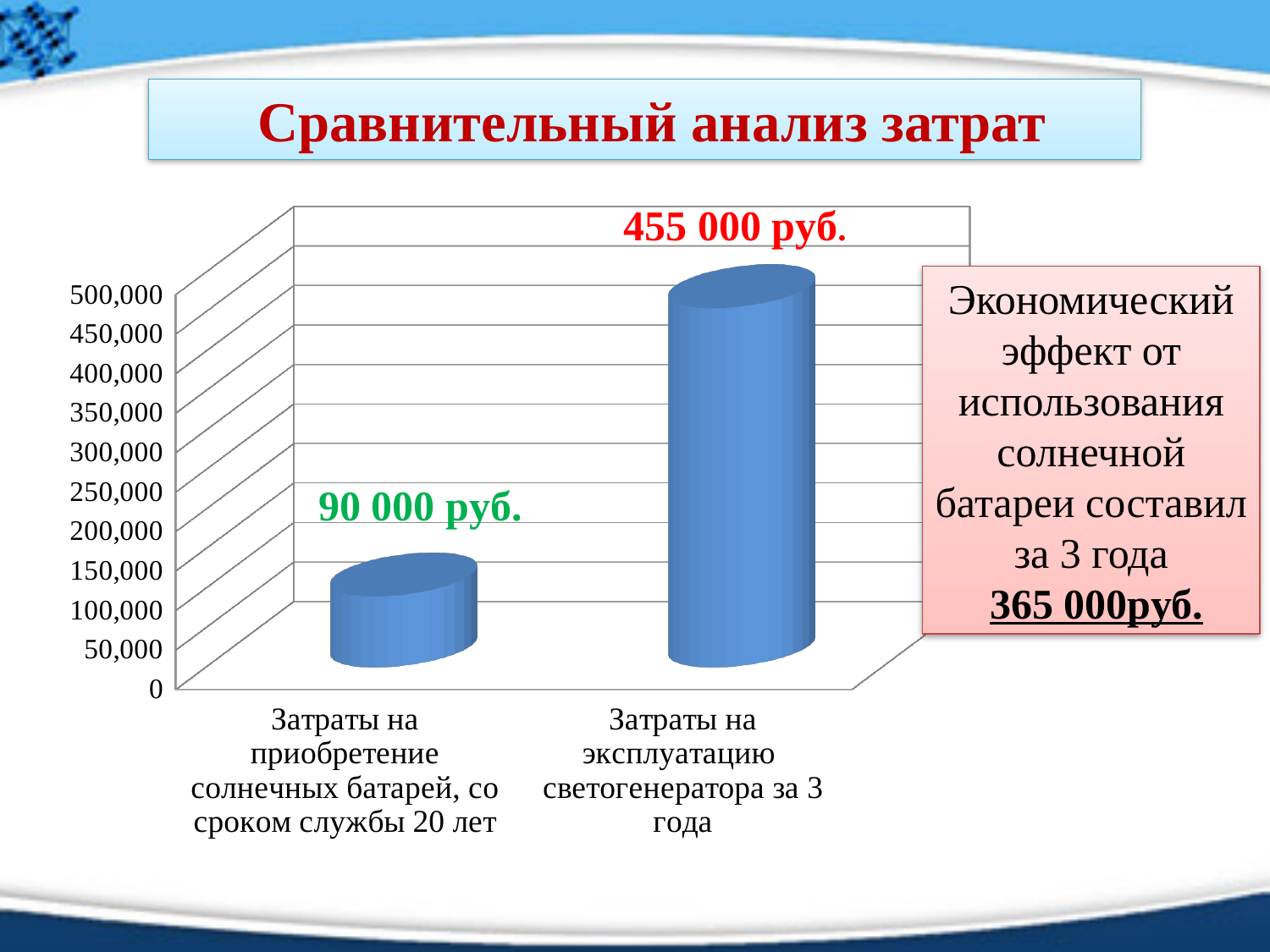
What is the value shown for "Затраты на приобретение солнечных батарей, со сроком службы 20 лет"? 90 000 руб. Which category has the highest value? Затраты на эксплуатацию светогенератора за 3 года What is the title of the slide containing the chart? Сравнительный анализ затрат What kind of chart is shown on the slide? bar chart How many categories are shown on the chart? 2 Is the value for "Затраты на приобретение солнечных батарей, со сроком службы 20 лет" greater or less than 150,000? less What is the highest value labelled on the vertical axis of the chart? 500,000 What is the value shown for "Затраты на эксплуатацию светогенератора за 3 года"? 455 000 руб. Which category has the lowest value? Затраты на приобретение солнечных батарей, со сроком службы 20 лет What is the difference between the value for "Затраты на эксплуатацию светогенератора за 3 года" and the value for "Затраты на приобретение солнечных батарей, со сроком службы 20 лет"? 365 000 руб. Which is larger: the value for "Затраты на приобретение солнечных батарей, со сроком службы 20 лет" or the value for "Затраты на эксплуатацию светогенератора за 3 года"? Затраты на эксплуатацию светогенератора за 3 года Is the value for "Затраты на эксплуатацию светогенератора за 3 года" greater or less than 400,000? greater